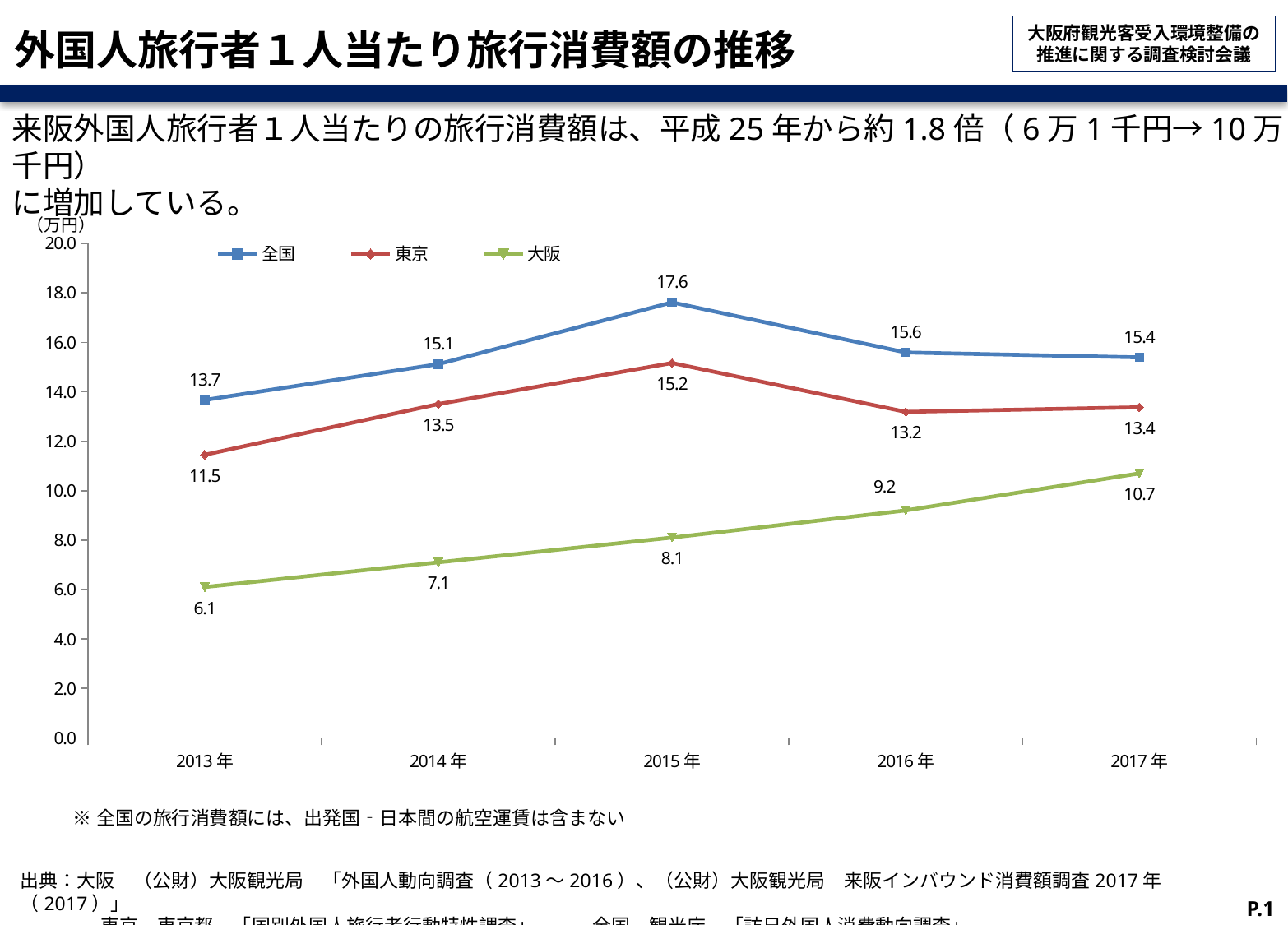
In which year is the 大阪 series lowest? 2013年 In which year does the 全国 series reach its highest value? 2015年 Which is larger in 2016年, the value for 東京 or the value for 大阪? 東京 Does the 大阪 series rise or fall from 2013年 to 2017年? rise How many years are shown on the x axis? 5 What is the value for 大阪 in 2017年? 10.7 What is the value for 東京 in 2013年? 11.5 What is the difference between the 全国 and 大阪 values in 2013年? 7.6 What kind of chart is shown on the slide? line chart What is the value for 全国 in 2015年? 17.6 What unit is shown at the top of the y axis? （万円） How many series does the legend list? 3